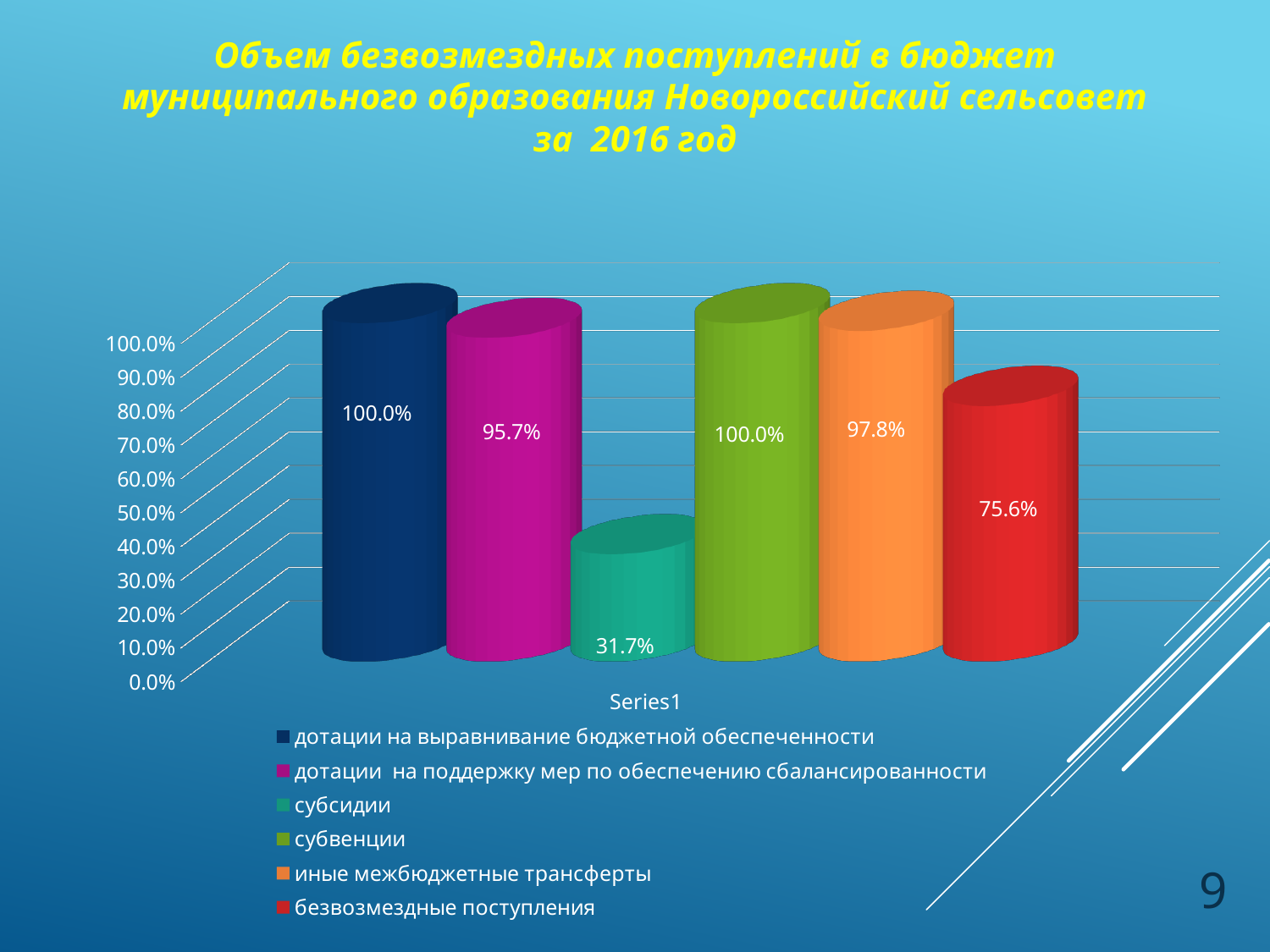
What is the value shown for безвозмездные поступления? 75.6% What is the value shown for дотации на поддержку мер по обеспечению сбалансированности? 95.7% What is the difference between the values for иные межбюджетные трансферты and безвозмездные поступления? 22.2% What is the value shown for субсидии? 31.7% How many series does the legend list? 6 What colour is the bar for субсидии? teal What kind of chart is shown on the slide? bar chart Which is larger, the value for дотации на поддержку мер по обеспечению сбалансированности or the value for безвозмездные поступления? дотации на поддержку мер по обеспечению сбалансированности Which legend entry has the lowest value? субсидии What is the value shown for субвенции? 100.0% What is the difference between the values for субвенции and субсидии? 68.3% What is the value shown for иные межбюджетные трансферты? 97.8%